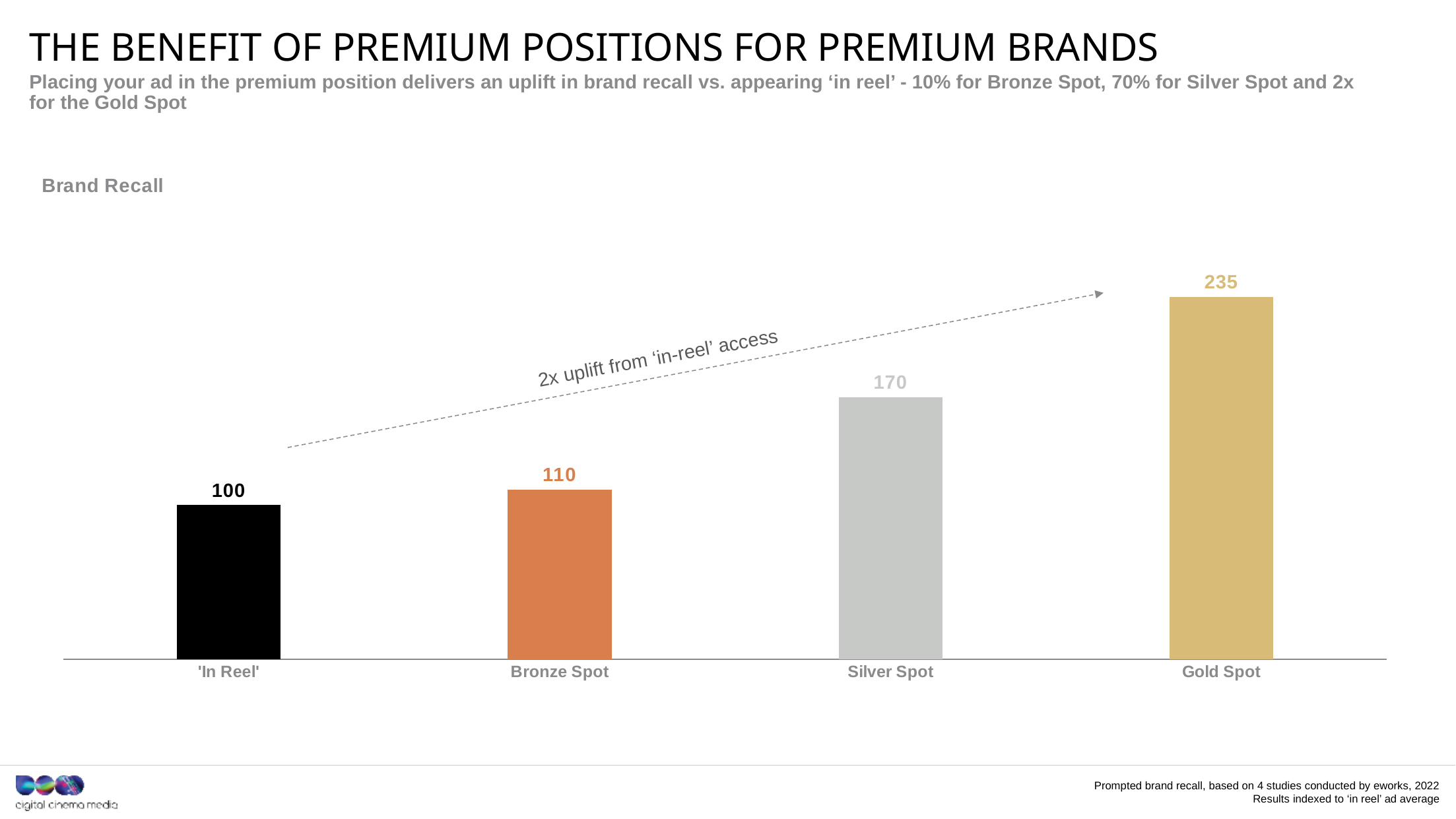
Do the brand recall values rise or fall from left to right across the categories? Rise Which category has the lowest brand recall? 'In Reel' What is the brand recall value for 'In Reel'? 100 Which has a higher brand recall, the Silver Spot or the Bronze Spot? Silver Spot What is the brand recall value for the Silver Spot? 170 What is the difference in brand recall between the Gold Spot and 'In Reel'? 135 What type of chart is shown on the slide? Bar chart Which category has the highest brand recall? Gold Spot What is the brand recall value for the Bronze Spot? 110 What is the brand recall value for the Gold Spot? 235 How many categories are shown in the chart? 4 What is the difference in brand recall between the Silver Spot and the Bronze Spot? 60